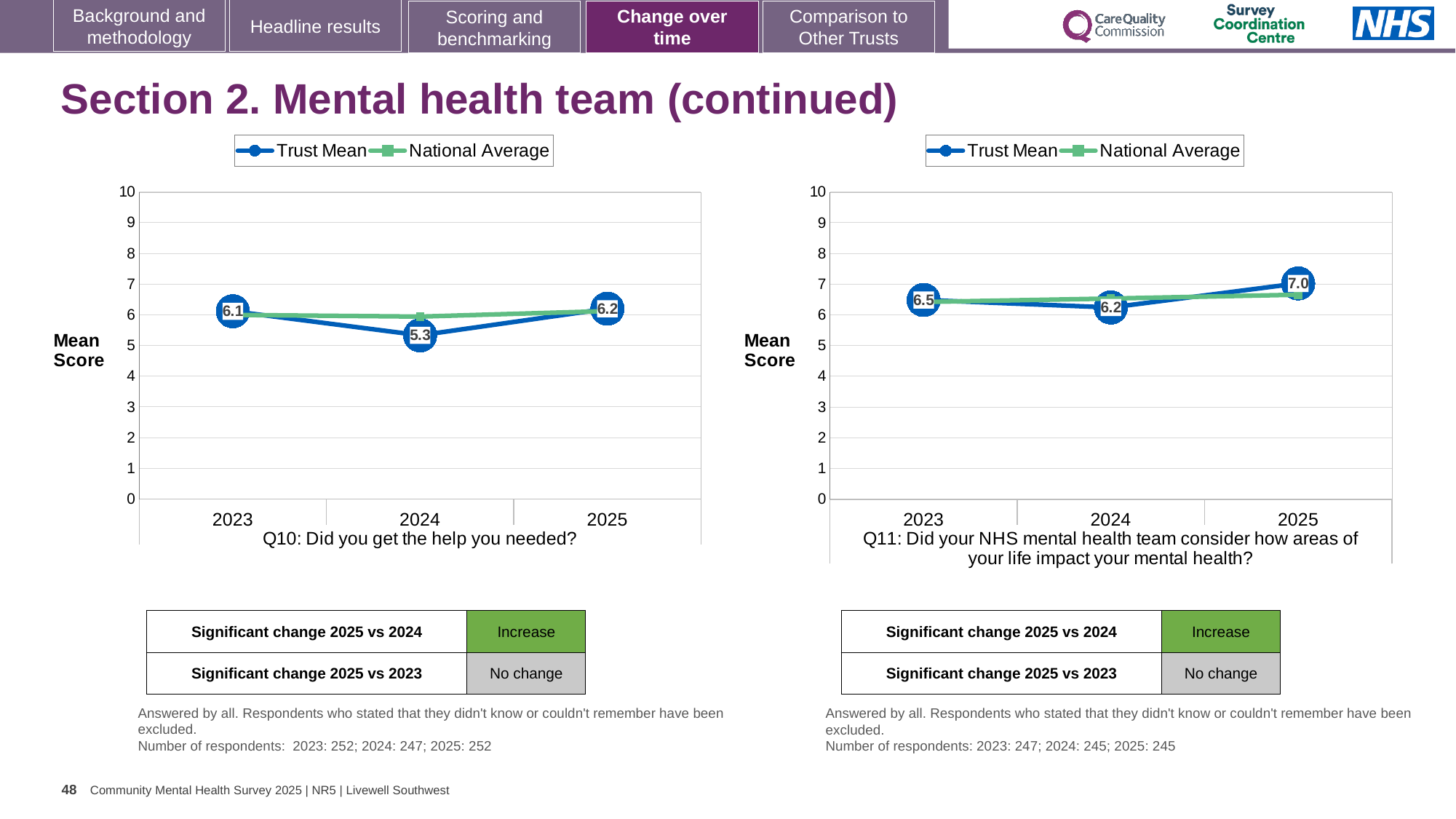
In the Q10 chart, what is the Trust Mean for 2024? 5.3 What kind of chart is the Q11 chart? Line chart In the Q10 chart, which year has the lowest Trust Mean? 2024 In the Q11 chart, how many years are plotted on the x axis? 3 In the Q11 chart, what is the difference between the Trust Mean for 2025 and the Trust Mean for 2024? 0.8 In the Q10 chart, what is the Trust Mean for 2025? 6.2 How many series does the legend of the Q10 chart list? 2 In the Q11 chart, what is the Trust Mean for 2023? 6.5 In the Q11 chart, what is the Trust Mean for 2025? 7.0 In the Q11 chart, which year has the highest Trust Mean? 2025 In the Q10 chart, is the Trust Mean for 2024 greater or less than 6? less In the Q10 chart, what is the difference between the Trust Mean for 2023 and the Trust Mean for 2024? 0.8